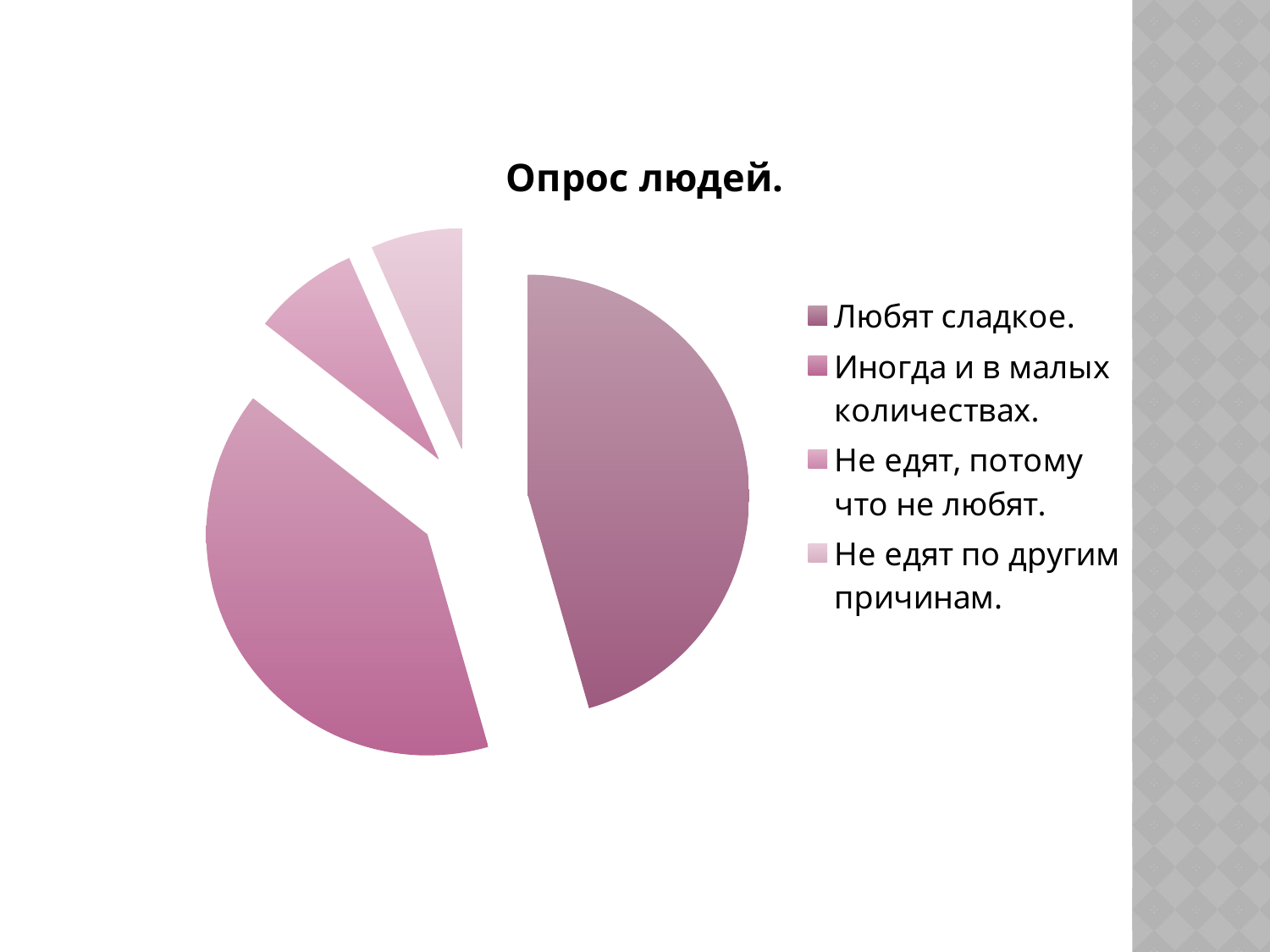
Which category has the smallest slice of the pie? Не едят по другим причинам. Which slice is larger: "Иногда и в малых количествах." or "Не едят, потому что не любят."? Иногда и в малых количествах. How many entries does the legend list? 4 Which slice is larger: "Любят сладкое." or "Не едят по другим причинам."? Любят сладкое. What is the title of the chart? Опрос людей. What kind of chart is shown on the slide? pie chart Which slice is larger: "Любят сладкое." or "Иногда и в малых количествах."? Любят сладкое. How many slices does the pie chart have? 4 Which category has the largest slice of the pie? Любят сладкое. Which legend entry is shown with the lightest colour? Не едят по другим причинам.